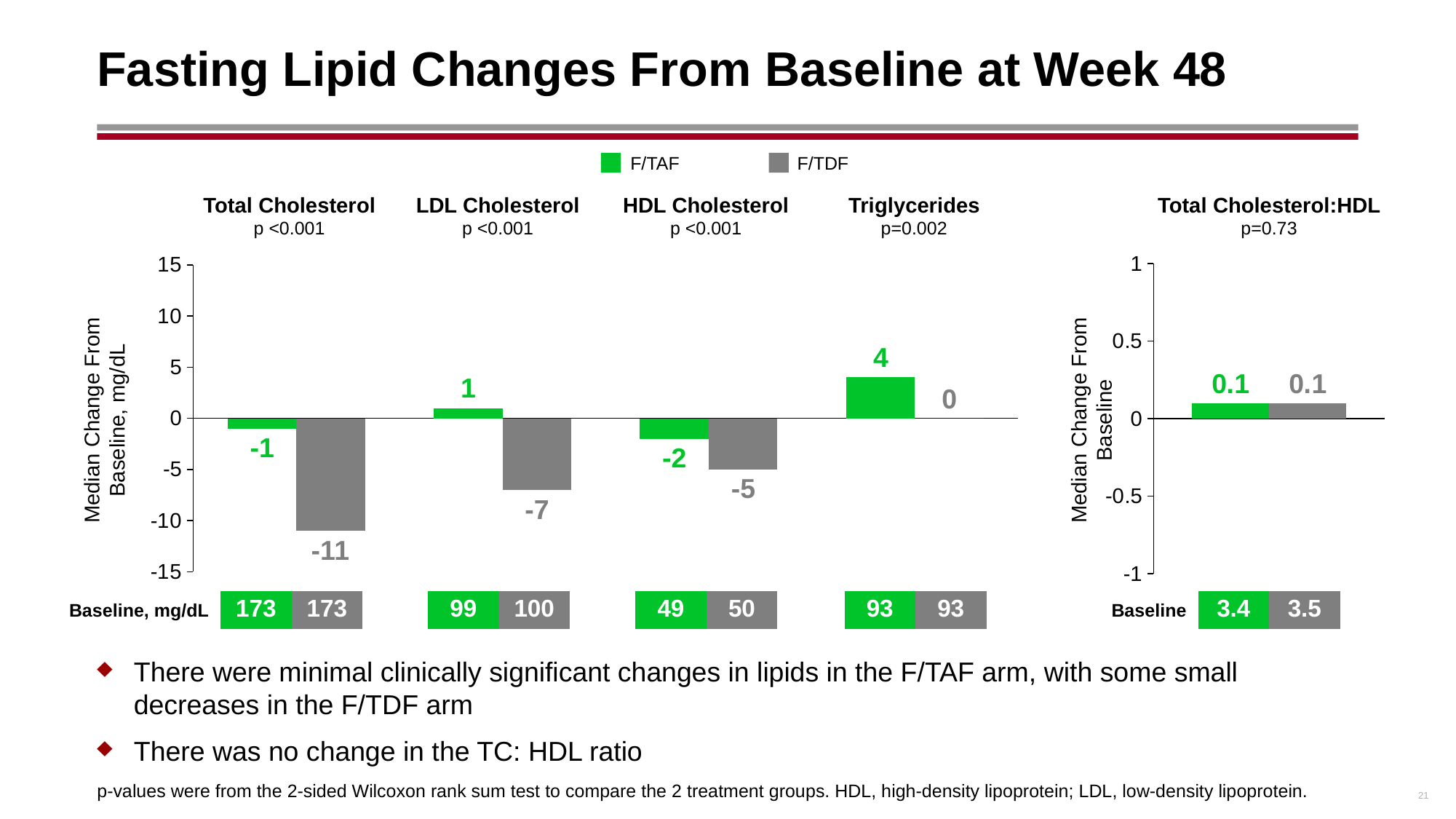
In the left chart, what is the median change from baseline in Triglycerides for the F/TAF arm? 4 In the right chart (Total Cholesterol:HDL), what is the median change from baseline for the F/TDF arm? 0.1 How many series does the legend list? 2 How many lipid parameters are plotted in the left chart? 4 In the left chart, what p-value is shown for Triglycerides? p=0.002 In the left chart, which lipid parameter has the lowest F/TDF value? Total Cholesterol In the left chart, for HDL Cholesterol, which arm has the larger median change from baseline? F/TDF In the left chart, what is the difference between the F/TAF and F/TDF median changes for Total Cholesterol? 10 What kind of chart is used on this slide? Bar chart In the left chart, what is the median change from baseline in LDL Cholesterol for the F/TDF arm? -7 In the left chart, which lipid parameter has the highest F/TAF value? Triglycerides In the left chart, what is the median change from baseline in Total Cholesterol for the F/TDF arm? -11